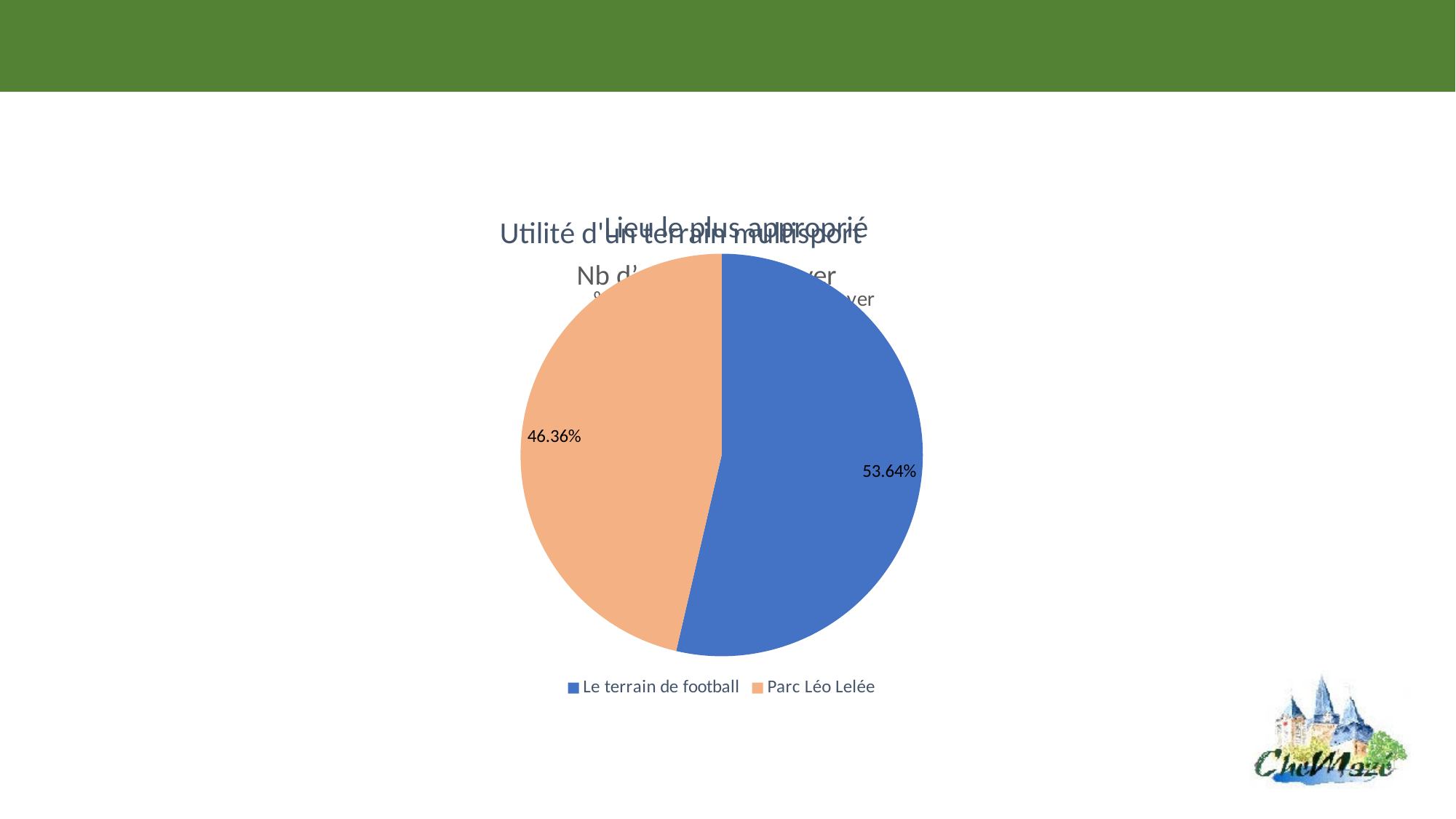
How many slices does the pie chart have? 2 What share of the pie does Parc Léo Lelée have? 46.36% Which slice of the pie is the largest? Le terrain de football What is the difference between the shares of Le terrain de football and Parc Léo Lelée? 7.28% What colour is the slice for Le terrain de football? blue Which is larger, the share for Le terrain de football or the share for Parc Léo Lelée? Le terrain de football Is the share for Le terrain de football greater or less than 50%? greater Which slice of the pie is the smallest? Parc Léo Lelée How many entries does the legend list? 2 What kind of chart is shown on the slide? pie chart What colour is the slice for Parc Léo Lelée? orange What share of the pie does Le terrain de football have? 53.64%